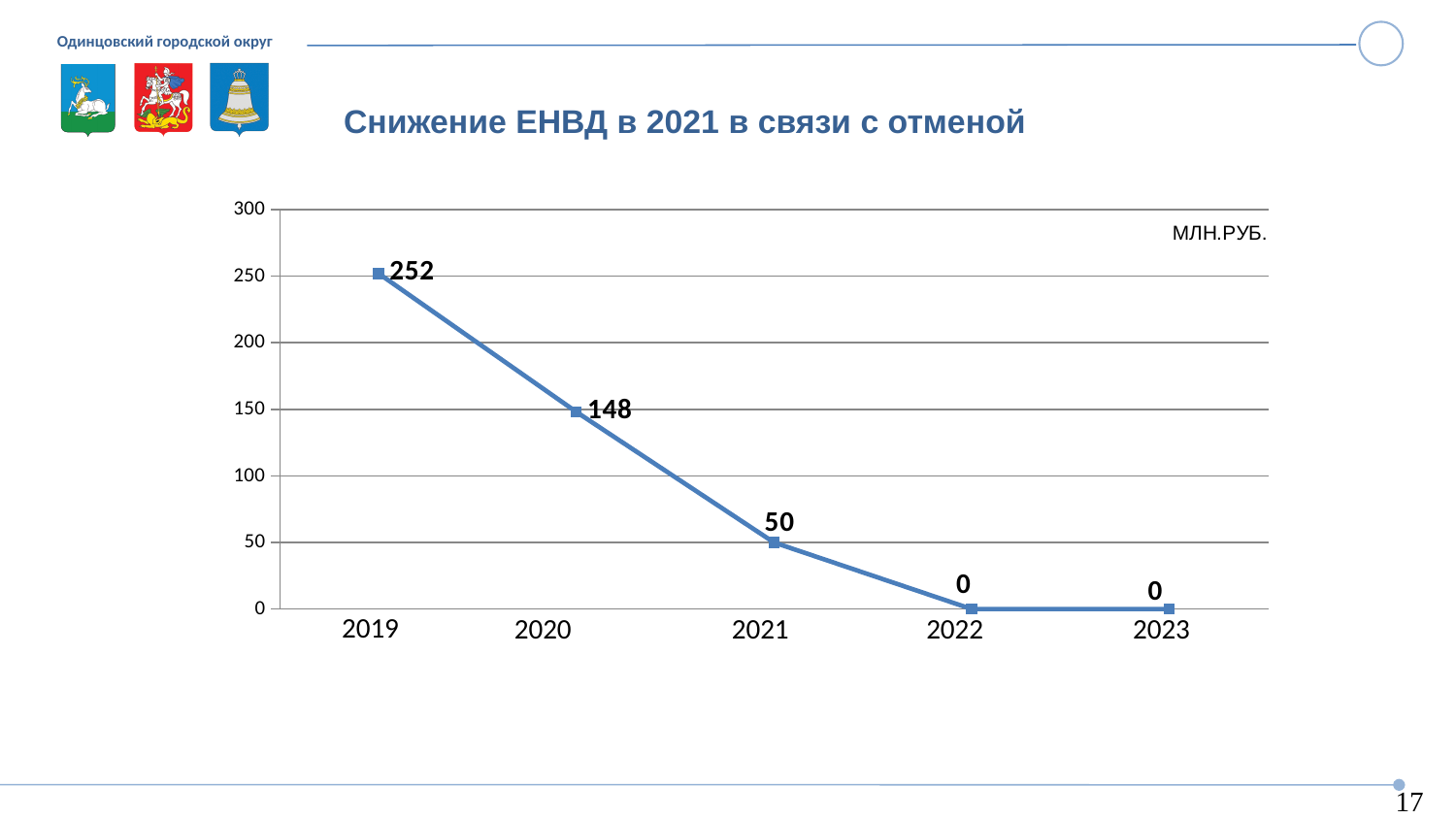
What is the value for 2019? 252 What is the difference between the values for 2020 and 2021? 98 What kind of chart is shown on the slide? line chart Which year has the highest value? 2019 What is the difference between the values for 2019 and 2020? 104 What is the value for 2021? 50 Do the values rise or fall from 2019 to 2021? fall What is the value for 2022? 0 How many years are plotted on the chart? 5 Which is larger, the value for 2020 or the value for 2021? 2020 What unit is indicated in the top right corner of the chart? МЛН.РУБ. What is the value for 2020? 148